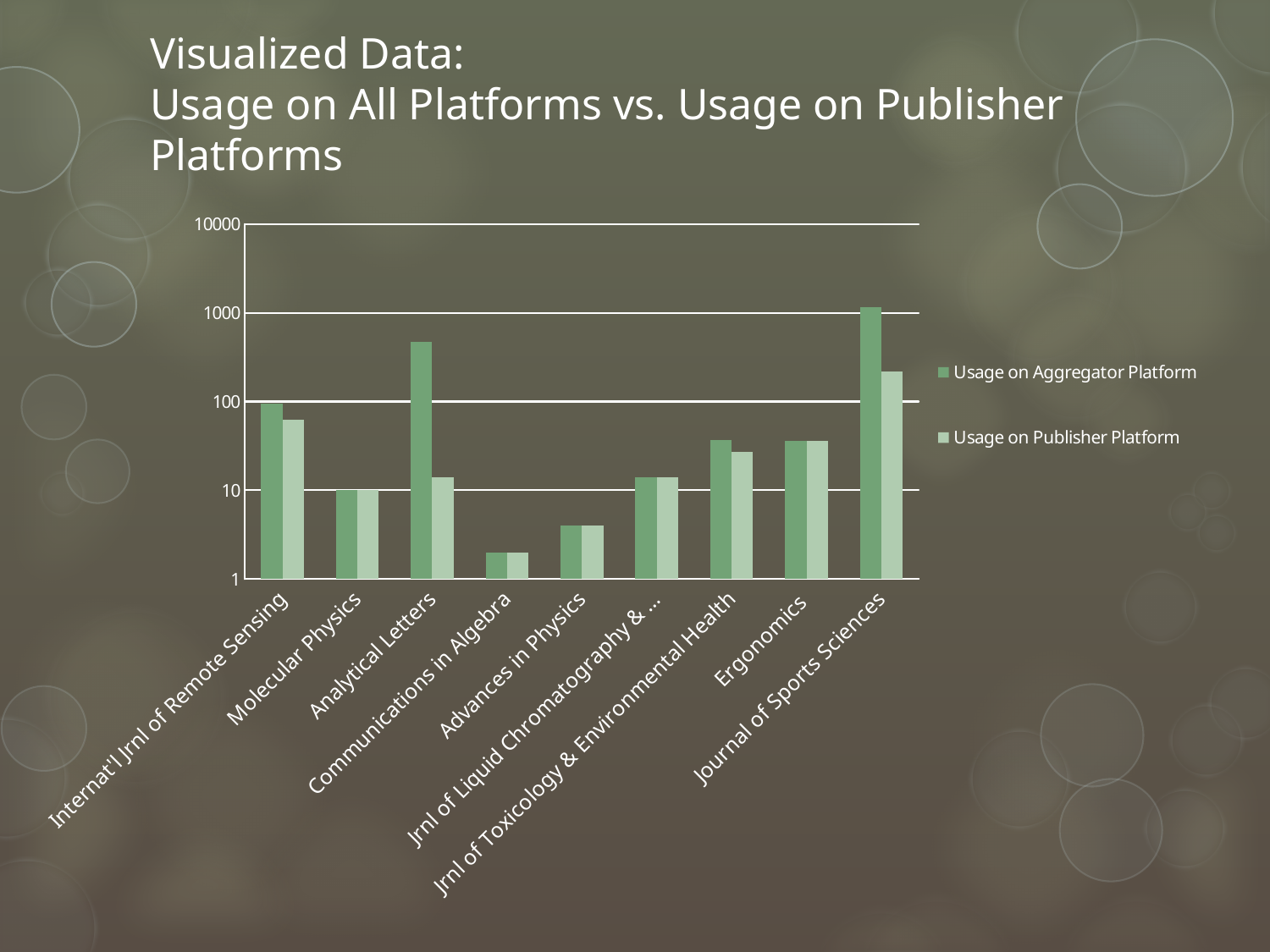
Is the Usage on Aggregator Platform for Analytical Letters greater or less than 100? greater What kind of chart is shown on the slide? Bar chart Which journal has the highest Usage on Aggregator Platform? Journal of Sports Sciences How many journals (categories) are plotted on the x axis? 9 What is the Usage on Aggregator Platform for Molecular Physics? 10 What are the two series named in the legend? Usage on Aggregator Platform; Usage on Publisher Platform For Analytical Letters, which is larger: Usage on Aggregator Platform or Usage on Publisher Platform? Usage on Aggregator Platform How many series does the legend list? 2 Is the Usage on Publisher Platform for Ergonomics greater or less than 100? less Is the Usage on Publisher Platform for Communications in Algebra greater or less than 10? less Which journal has the lowest Usage on Aggregator Platform? Communications in Algebra